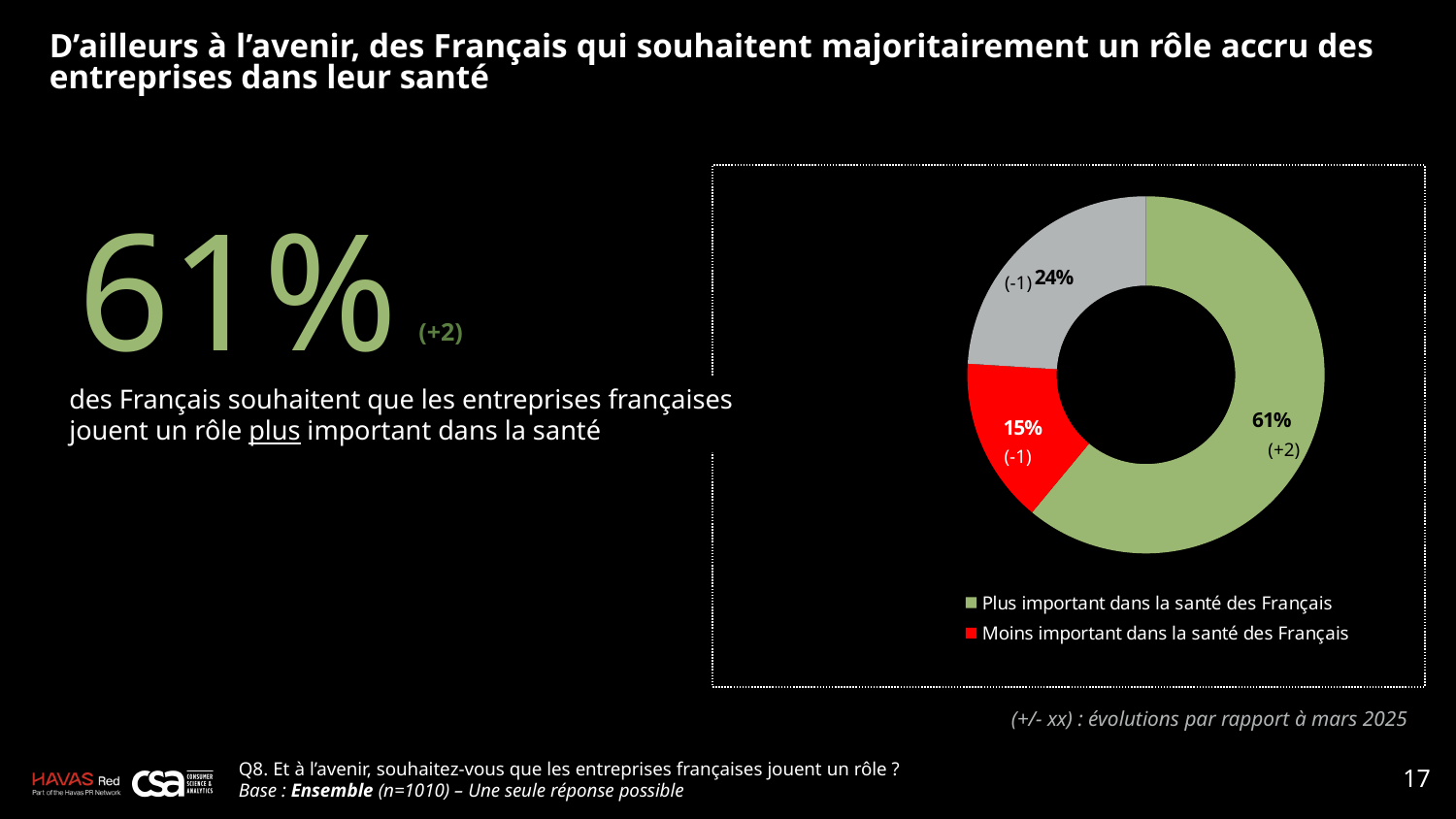
How many entries does the chart legend list? 2 Which slice of the donut chart is the largest? Plus important dans la santé des Français (61%) How many slices does the donut chart have? 3 What share of respondents answered "Plus important dans la santé des Français"? 61% Which is larger: the grey slice or the "Moins important dans la santé des Français" slice? The grey slice (24%) What is the difference in percentage points between "Plus important dans la santé des Français" and "Moins important dans la santé des Français"? 46 points What share of respondents answered "Moins important dans la santé des Français"? 15% What kind of chart is shown on the slide? Donut (pie) chart What percentage is shown on the grey slice of the donut chart? 24% What change versus March 2025 is shown next to the 61% slice? +2 Which slice of the donut chart is the smallest? Moins important dans la santé des Français (15%) What colour is the "Moins important dans la santé des Français" slice? Red